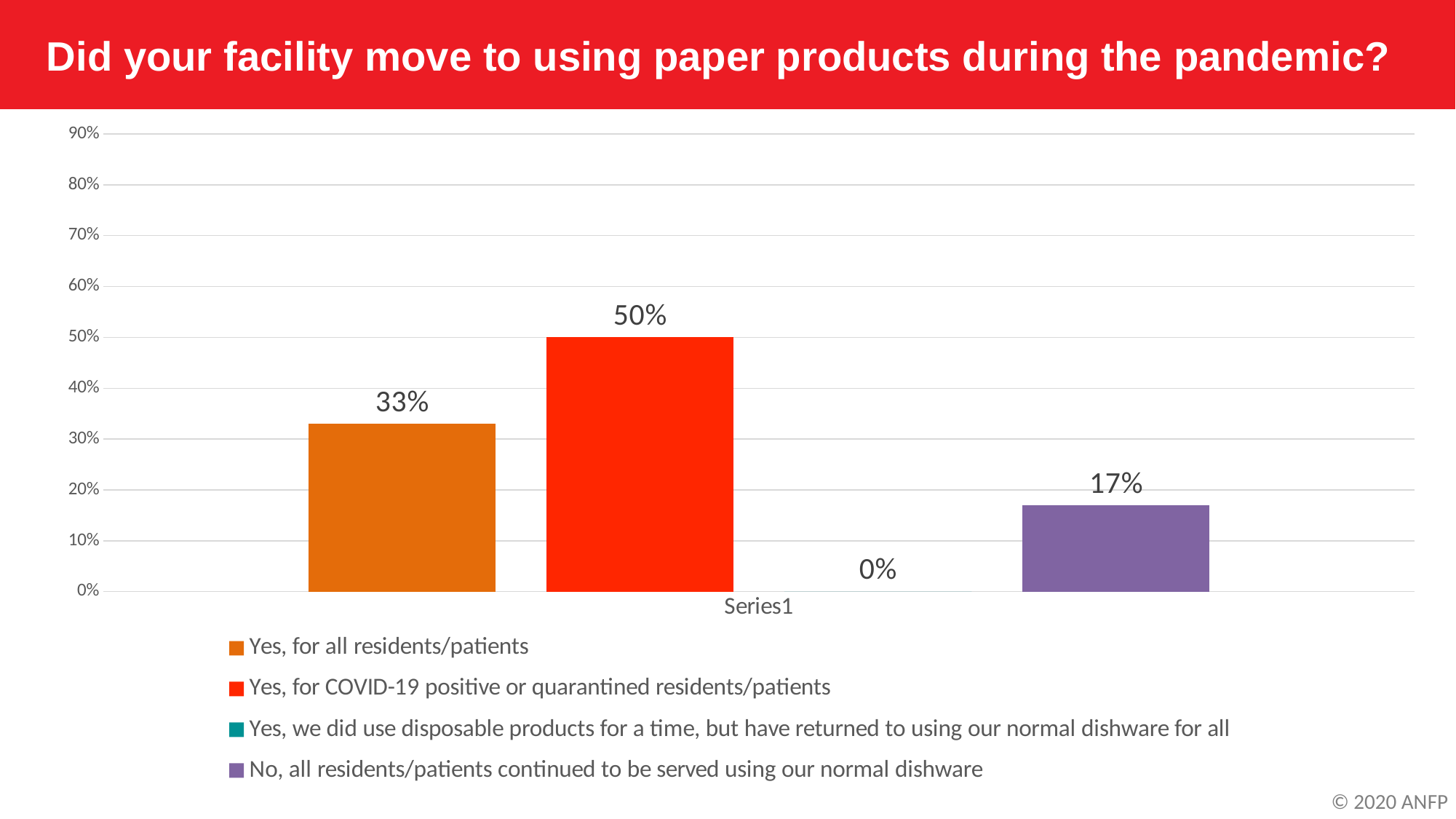
How many response options does the legend list? 4 What percentage of facilities answered "Yes, we did use disposable products for a time, but have returned to using our normal dishware for all"? 0% What percentage of facilities answered "Yes, for COVID-19 positive or quarantined residents/patients"? 50% Which is larger: the percentage for "Yes, for all residents/patients" or for "No, all residents/patients continued to be served using our normal dishware"? Yes, for all residents/patients Which response has the lowest percentage? Yes, we did use disposable products for a time, but have returned to using our normal dishware for all What kind of chart is shown on the slide? Bar chart What is the difference in percentage points between "Yes, for COVID-19 positive or quarantined residents/patients" and "Yes, for all residents/patients"? 17% Which response has the highest percentage? Yes, for COVID-19 positive or quarantined residents/patients What percentage of facilities answered "Yes, for all residents/patients"? 33% What percentage of facilities answered "No, all residents/patients continued to be served using our normal dishware"? 17% What is the difference in percentage points between "Yes, for all residents/patients" and "No, all residents/patients continued to be served using our normal dishware"? 16% What is the title of the slide? Did your facility move to using paper products during the pandemic?